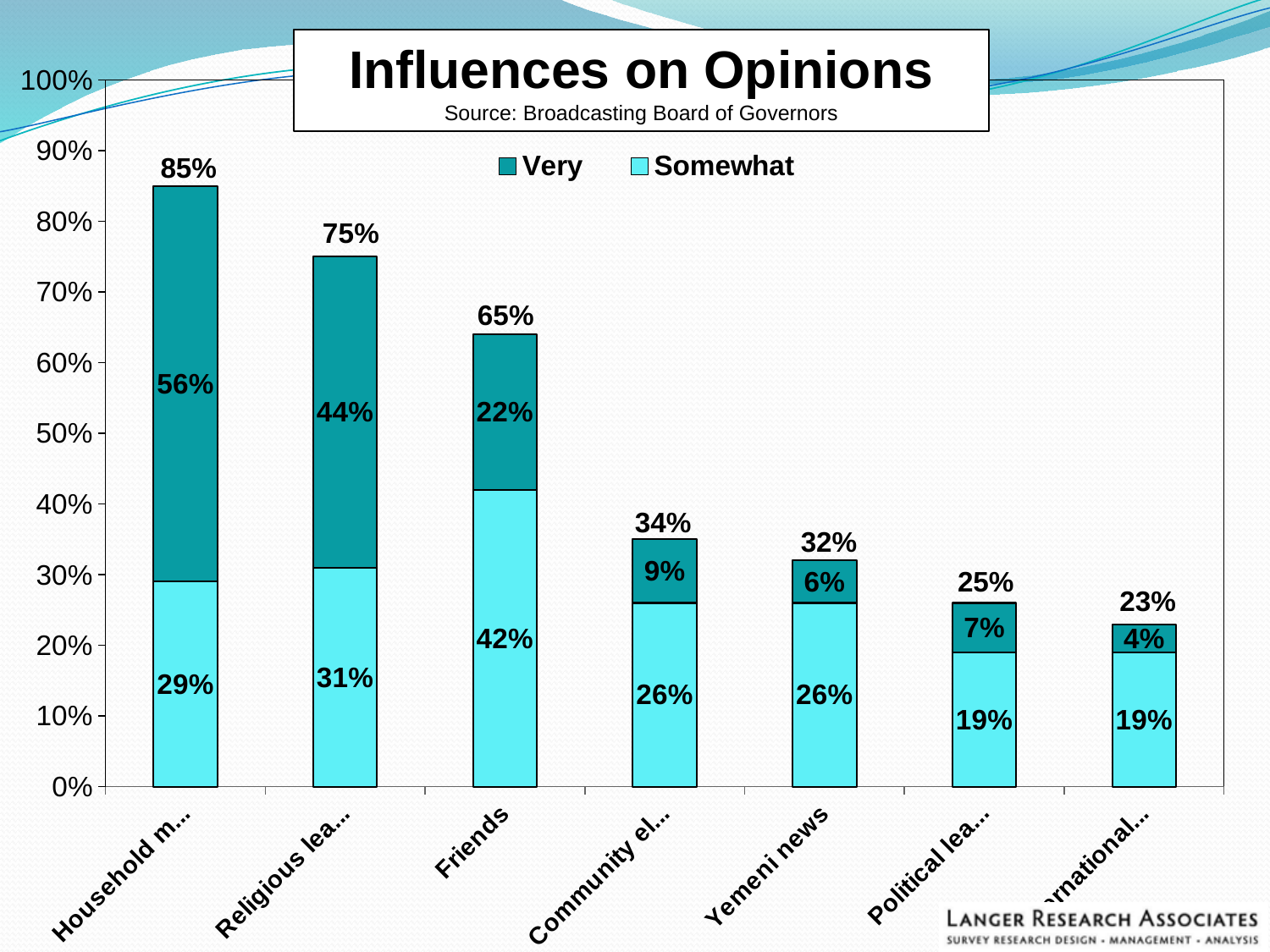
How many series does the legend list? 2 What are the two legend entries? Very and Somewhat How many categories are plotted on the x axis? 7 What source is cited under the chart title? Broadcasting Board of Governors What is the total shown above the Friends bar? 65% What is the difference between the total for Friends and the total for Yemeni news? 33 percentage points What is the 'Very' value for Yemeni news? 6% What is the 'Very' value for Friends? 22% What kind of chart is shown on the slide? Stacked bar chart What is the 'Somewhat' value for Yemeni news? 26% Which has the larger total, Friends or Yemeni news? Friends Do the bar totals rise or fall from left to right along the x axis? Fall